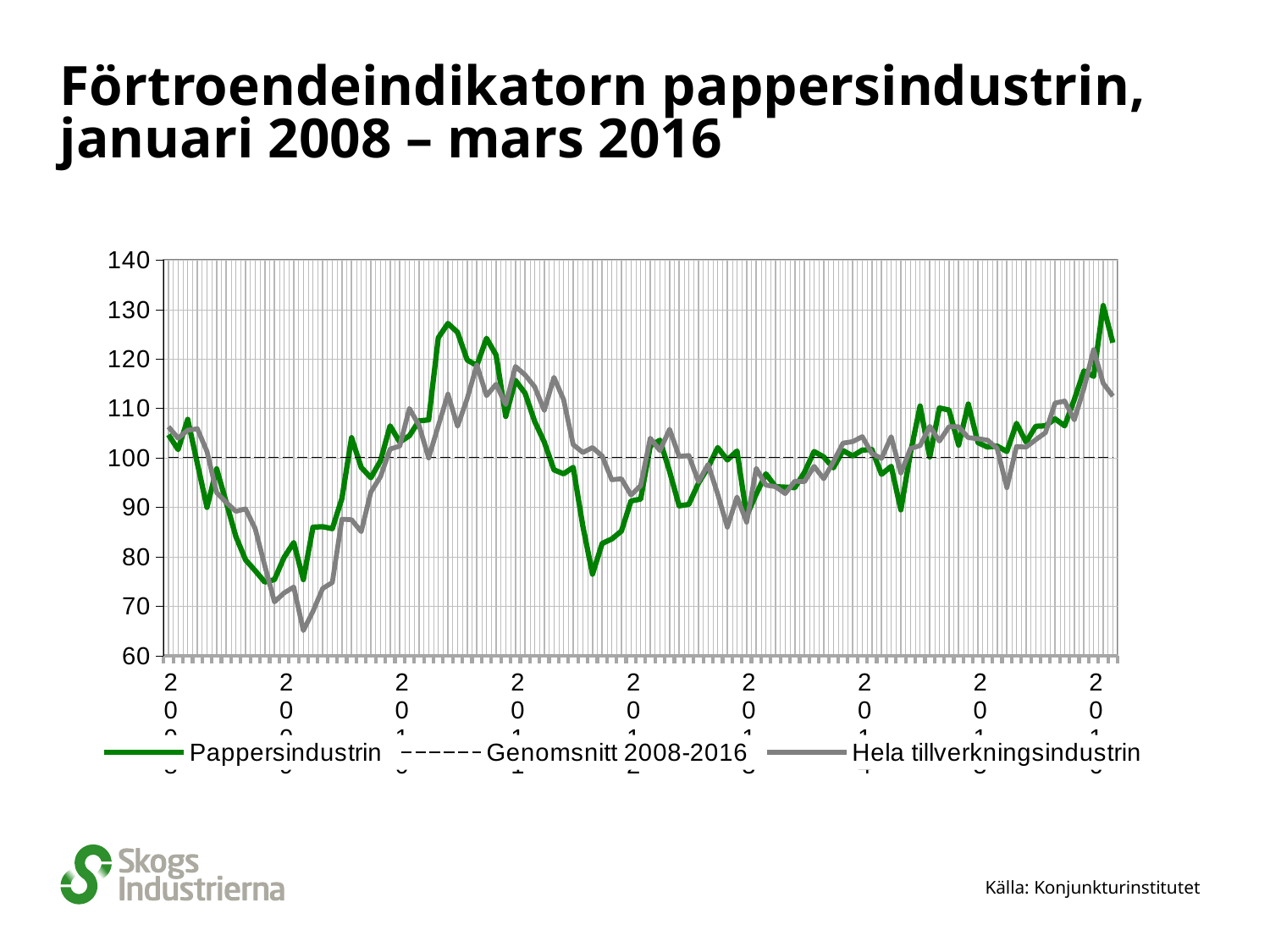
What is the title of the chart on the slide? Förtroendeindikatorn pappersindustrin, januari 2008 – mars 2016 Does the Pappersindustrin line rise or fall from 2014 to the end of the period in 2016? rise Which series is drawn as a dashed line? Genomsnitt 2008-2016 What kind of chart is shown on the slide? line chart How many series does the legend list? 3 Does the Pappersindustrin line rise or fall from the start of 2008 to early 2009? fall Is the lowest value of Pappersindustrin (in 2009) greater or less than 80? less At what value does the Genomsnitt 2008-2016 line sit? 100 Is the highest value of Pappersindustrin (in 2016) greater or less than 120? greater Which series reaches the lower minimum value over the period, Pappersindustrin or Hela tillverkningsindustrin? Hela tillverkningsindustrin Is the lowest value of Hela tillverkningsindustrin (in 2009) greater or less than 70? less At the end of the period (March 2016), which series is higher, Pappersindustrin or Hela tillverkningsindustrin? Pappersindustrin